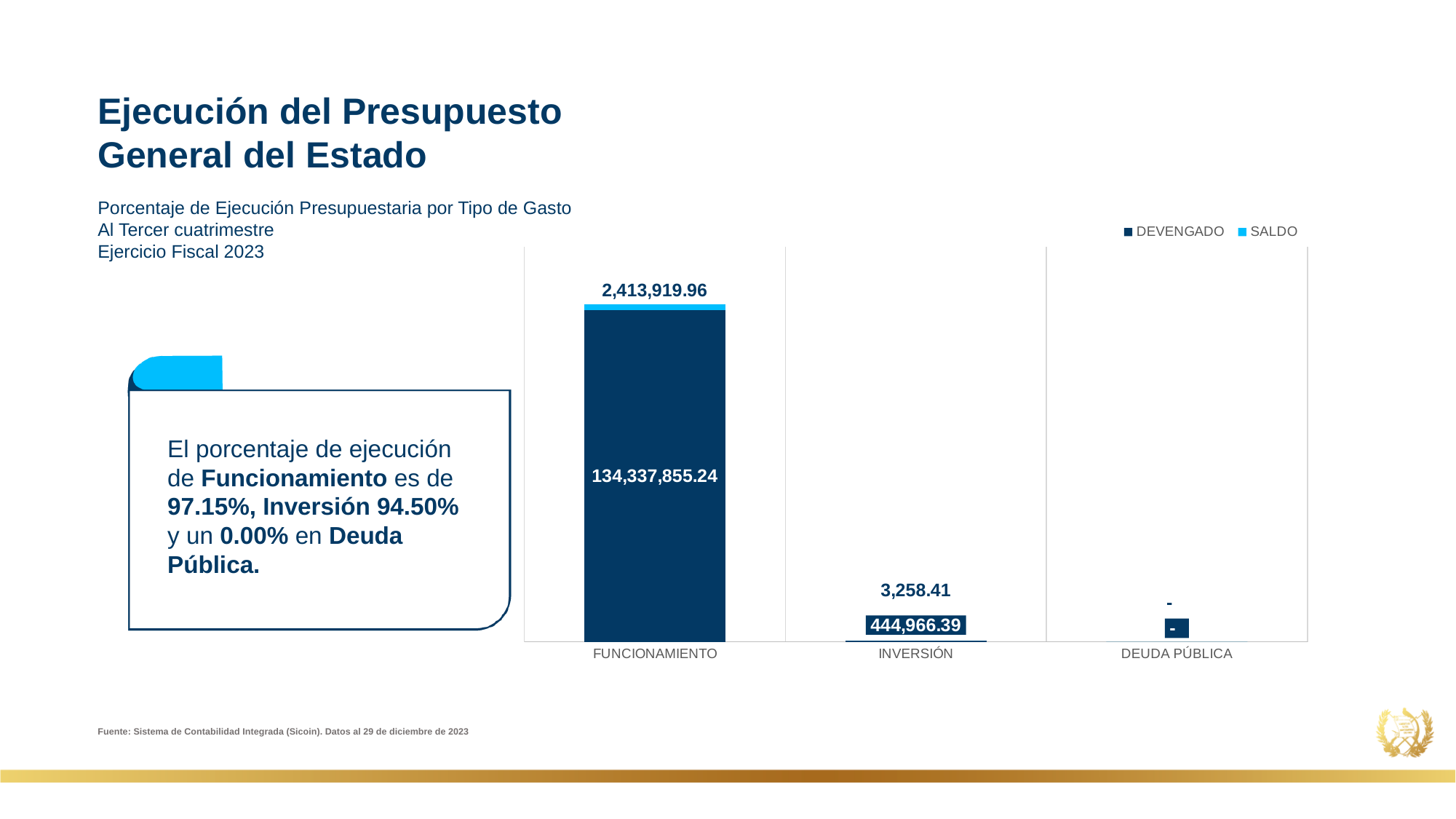
What is the SALDO value for INVERSIÓN? 3,258.41 How many categories are shown on the x axis of the chart? 3 What is the DEVENGADO value for FUNCIONAMIENTO? 134,337,855.24 What is the total of the stacked bar for INVERSIÓN? 448,224.80 Which category has the highest DEVENGADO value? FUNCIONAMIENTO What is the SALDO value for FUNCIONAMIENTO? 2,413,919.96 What is the difference between the DEVENGADO values for FUNCIONAMIENTO and INVERSIÓN? 133,892,888.85 How many series does the chart legend list? 2 Which series is shown in light blue in the legend? SALDO What is the DEVENGADO value for INVERSIÓN? 444,966.39 What type of chart is shown on the slide? Stacked bar chart Which category has the lowest total bar? DEUDA PÚBLICA